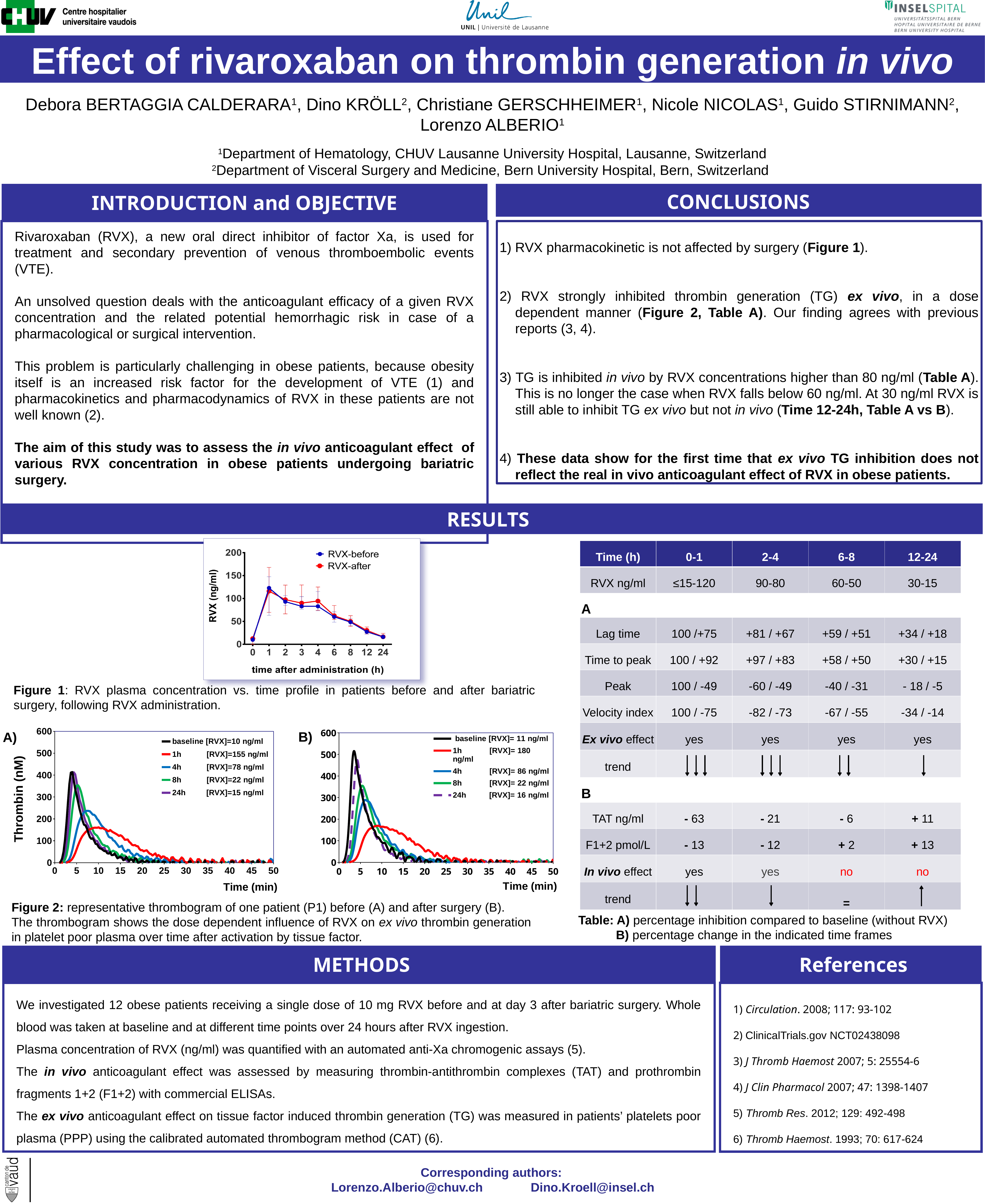
In Figure 1, is the RVX-before value at 1 h greater or less than 100 ng/ml? greater In Figure 1, do the RVX concentrations rise or fall between 1 h and 24 h after administration? fall In Figure 2B, is the peak thrombin value of the baseline curve greater or less than 400 nM? greater In Figure 2A, is the peak thrombin value of the 1h curve greater or less than 200 nM? less How many series does the legend of Figure 1 list? 2 What kind of chart is Figure 1 (RVX plasma concentration vs. time)? line chart How many series does the legend of Figure 2A list? 5 What is the x-axis label of Figure 2A and Figure 2B? Time (min) How many time points are marked on the x axis of Figure 1? 9 What are the two series named in the legend of Figure 1? RVX-before and RVX-after In Figure 2A, which series has the lowest thrombin peak? 1h [RVX]=155 ng/ml